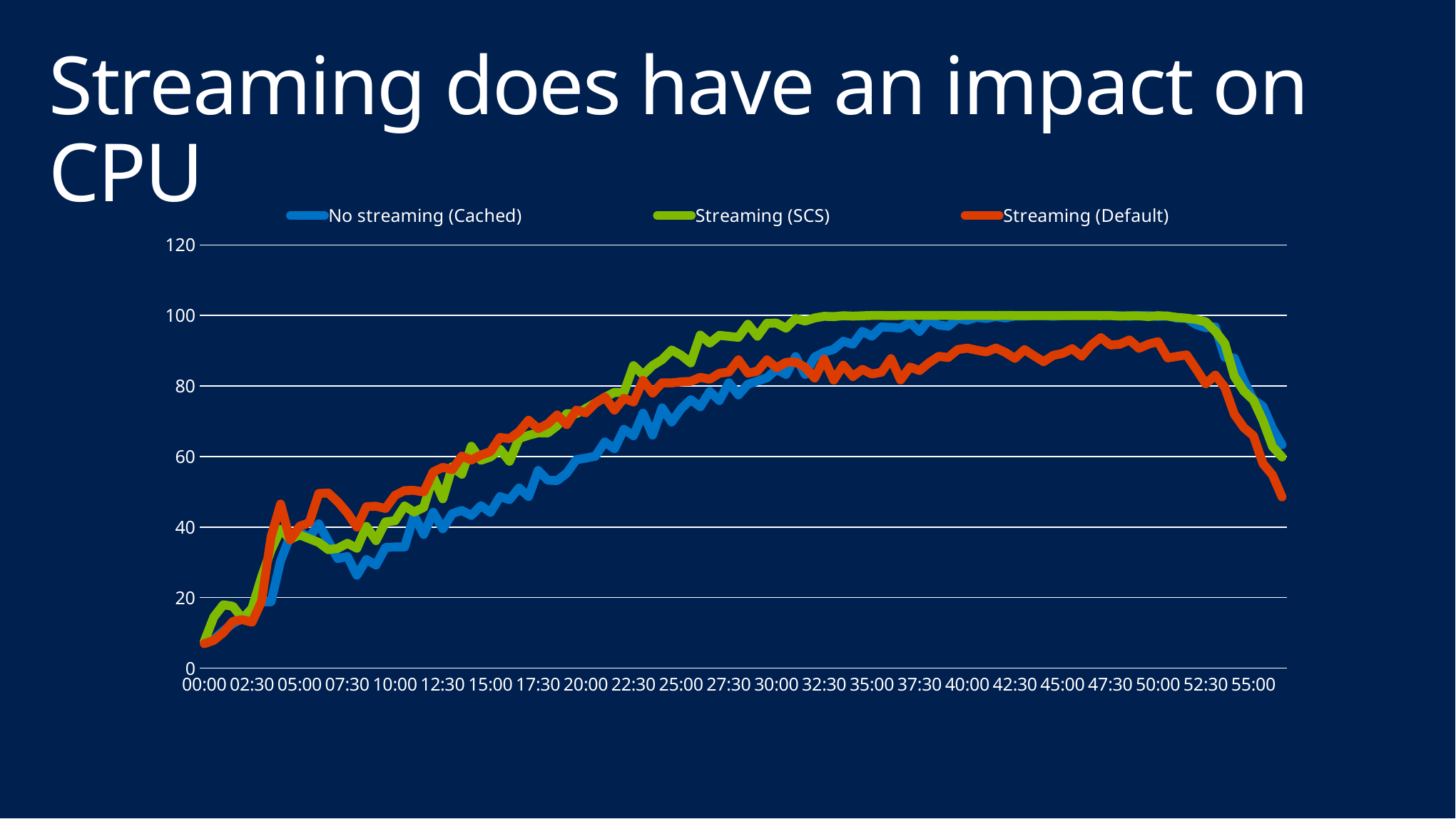
How many series does the legend list? 3 What kind of chart is shown on the slide? line chart At 20:00, which is larger: Streaming (Default) or No streaming (Cached)? Streaming (Default) Is the value for Streaming (SCS) at 40:00 greater or less than 80? greater What colour is the Streaming (SCS) line? green At 45:00, which is larger: Streaming (SCS) or Streaming (Default)? Streaming (SCS) Is the value for Streaming (Default) at 00:00 greater or less than 20? less Is the value for No streaming (Cached) at 10:00 greater or less than 60? less What are the three series named in the legend? No streaming (Cached), Streaming (SCS), Streaming (Default) What is the highest value labelled on the y axis? 120 Does the Streaming (SCS) line rise or fall between 00:00 and 40:00? rise